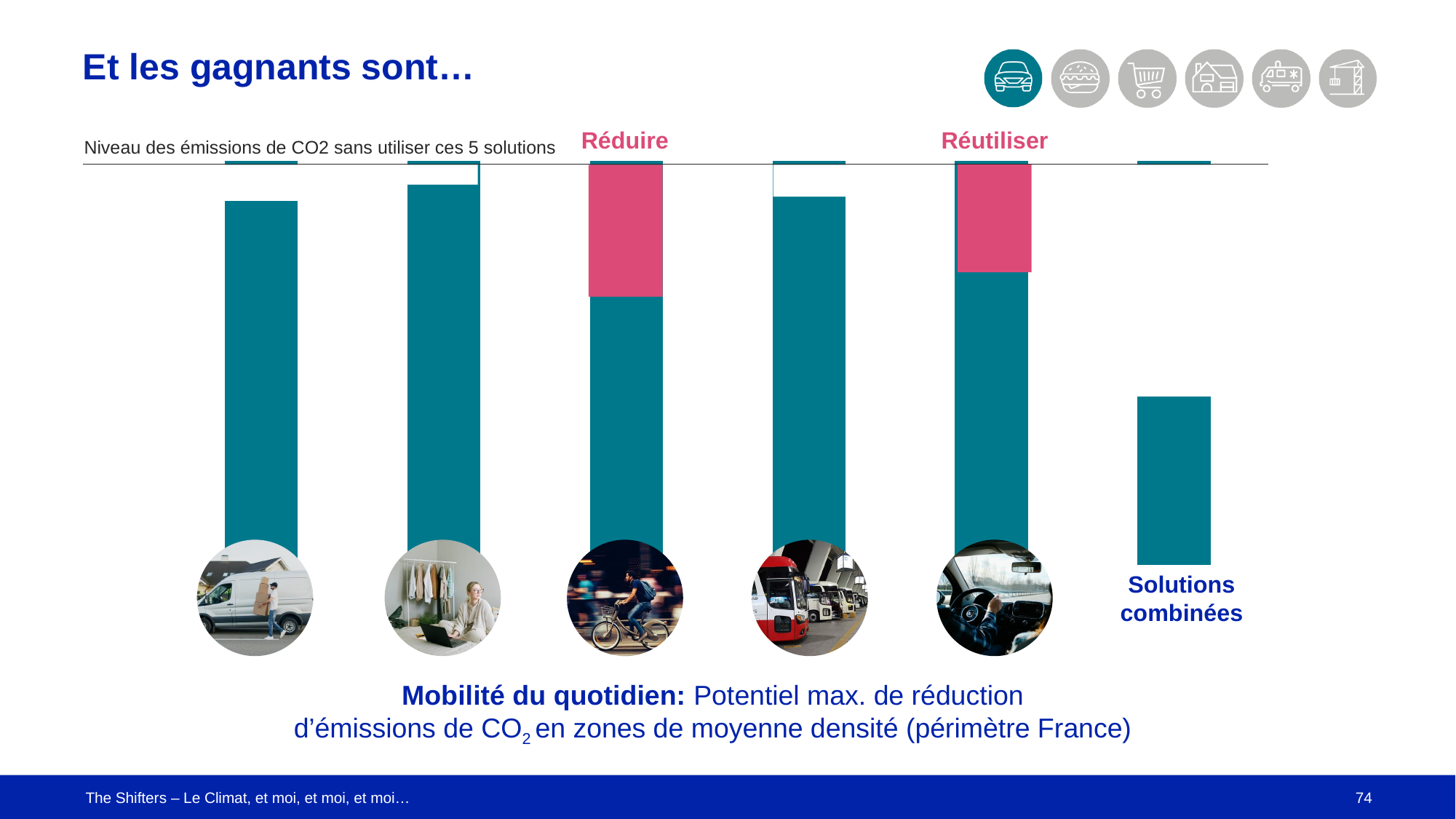
Which of the two highlighted reductions is larger, the one labelled "Réduire" or the one labelled "Réutiliser"? Réduire What colour are the segments labelled "Réduire" and "Réutiliser" in the chart? pink How many bars are plotted in the chart? 6 What kind of chart is shown on the slide? bar chart What does the horizontal reference line at the top of the chart represent, according to its label? Niveau des émissions de CO2 sans utiliser ces 5 solutions Which category has the lowest bar in the chart? Solutions combinées Is the bar for "Solutions combinées" taller or shorter than the bar highlighted with "Réutiliser"? shorter